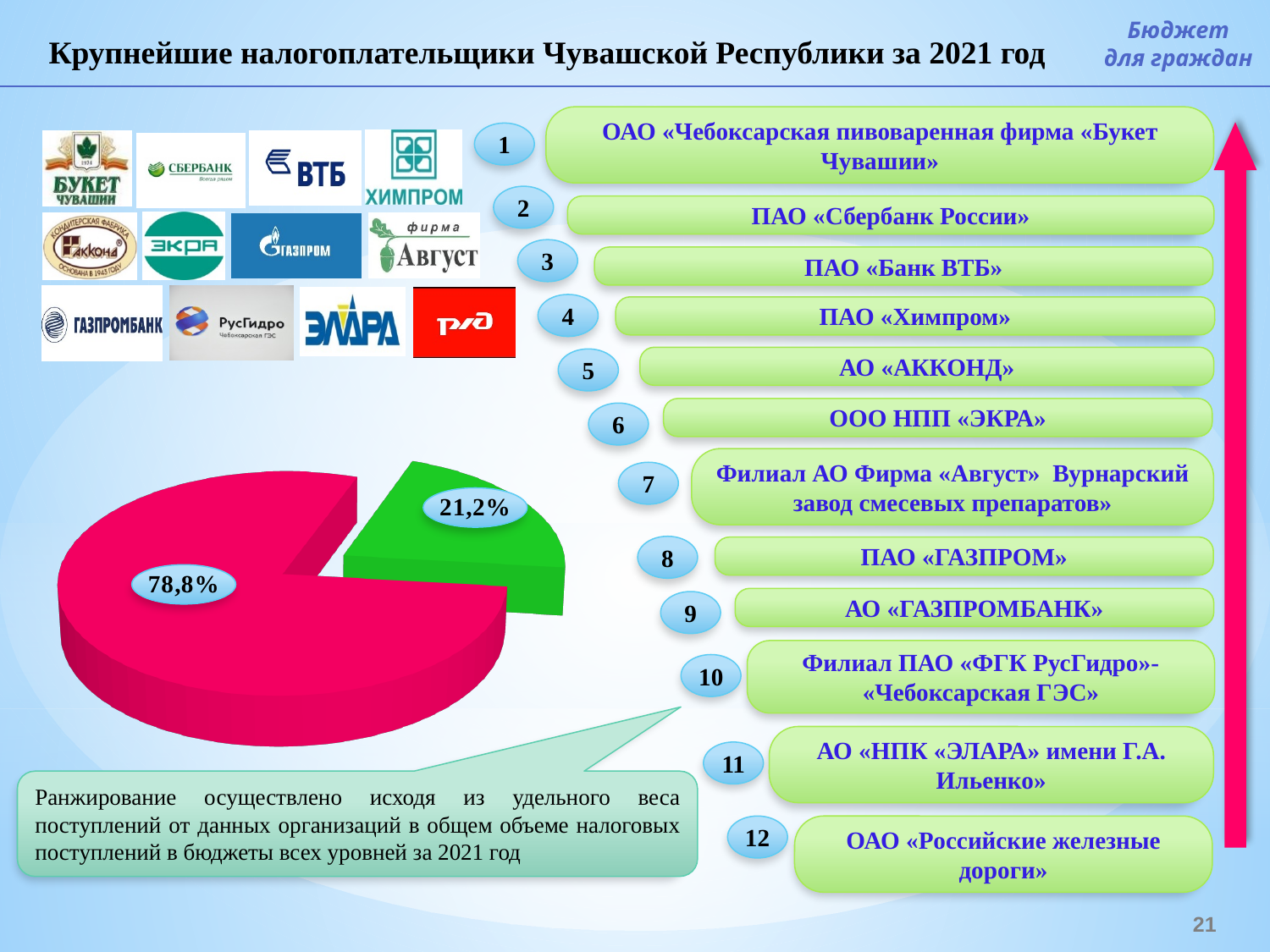
What value is shown on the pink slice of the pie chart? 78,8% Which slice of the pie chart is the largest? the pink slice (78,8%) What kind of chart is shown on the left side of the slide? pie chart Which is larger in the pie chart, the pink slice or the green slice? the pink slice Which slice of the pie chart is the smallest? the green slice (21,2%) What is the difference between the pink slice and the green slice of the pie chart? 57,6% What do the two slices of the pie chart add up to? 100% How many slices does the pie chart have? 2 What value is shown on the green slice of the pie chart? 21,2% Is the value of the green slice of the pie chart greater or less than 25%? less What colour is the slice labelled 78,8% in the pie chart? pink What share of the pie does the green slice represent? 21,2%